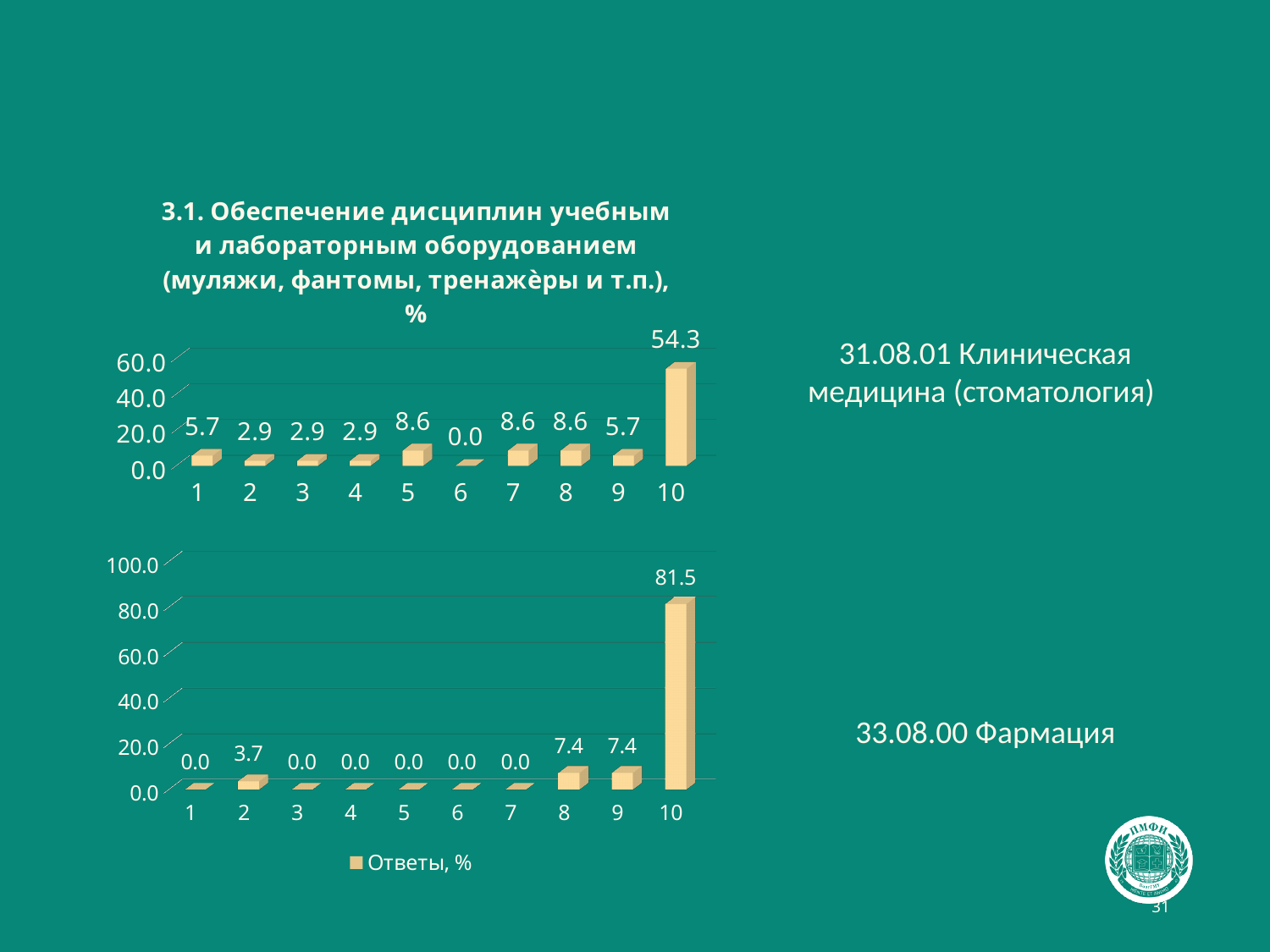
In the bottom chart, which category has the highest value? 10 In the top chart, what is the value for category 5? 8.6 In the top chart, which category has the lowest value? 6 In the bottom chart, what is the difference between the values for category 10 and category 8? 74.1 What type of chart is the bottom chart? bar chart What series name does the legend of the bottom chart show? Ответы, % In the bottom chart, which is larger, the value for category 2 or the value for category 8? category 8 In the bottom chart, what is the value for category 2? 3.7 In the top chart, what is the difference between the values for category 10 and category 9? 48.6 In the top chart, how many categories are shown on the x axis? 10 In the top chart, what is the value for category 10? 54.3 In the bottom chart, what is the value for category 10? 81.5